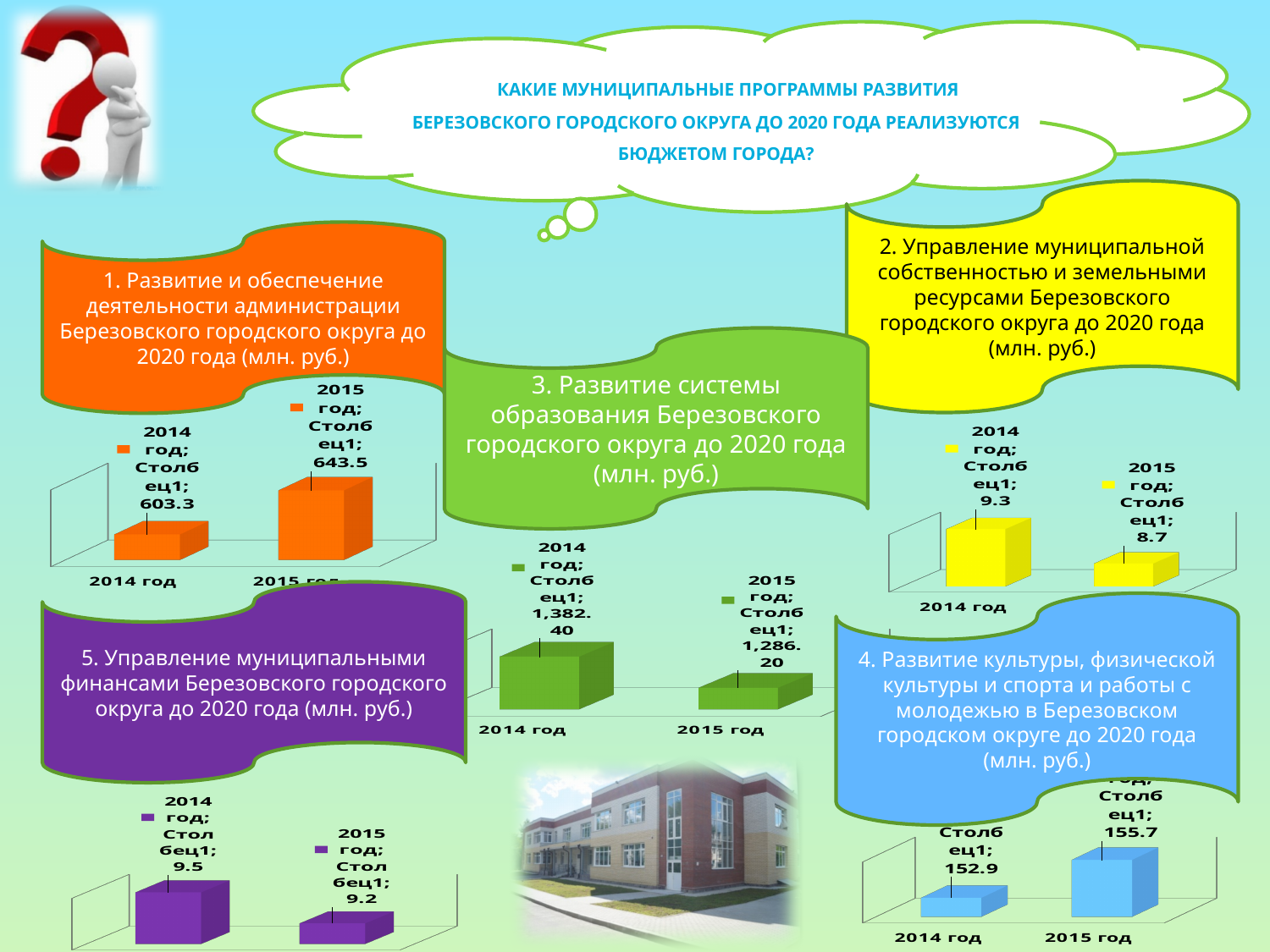
In the green bar chart in the centre of the slide, what is the value for 2014 год? 1,382.40 How many bar charts are shown on the slide? 5 In the green bar chart in the centre of the slide, do the values rise or fall from 2014 год to 2015 год? fall In the orange bar chart at the top left, what is the difference between the 2015 год and 2014 год values? 40.2 In the blue bar chart at the bottom right, which is larger, the value for 2014 год or for 2015 год? 2015 год In the purple bar chart at the bottom left, what is the value for 2014 год? 9.5 In the green bar chart in the centre of the slide, what is the value for 2015 год? 1,286.20 In the blue bar chart at the bottom right, what is the value for 2015 год? 155.7 In the yellow bar chart at the top right, which year has the lower value? 2015 год In the orange bar chart at the top left, what is the value for 2014 год? 603.3 In the yellow bar chart at the top right, what is the value for 2014 год? 9.3 In the orange bar chart at the top left, what is the value for 2015 год? 643.5